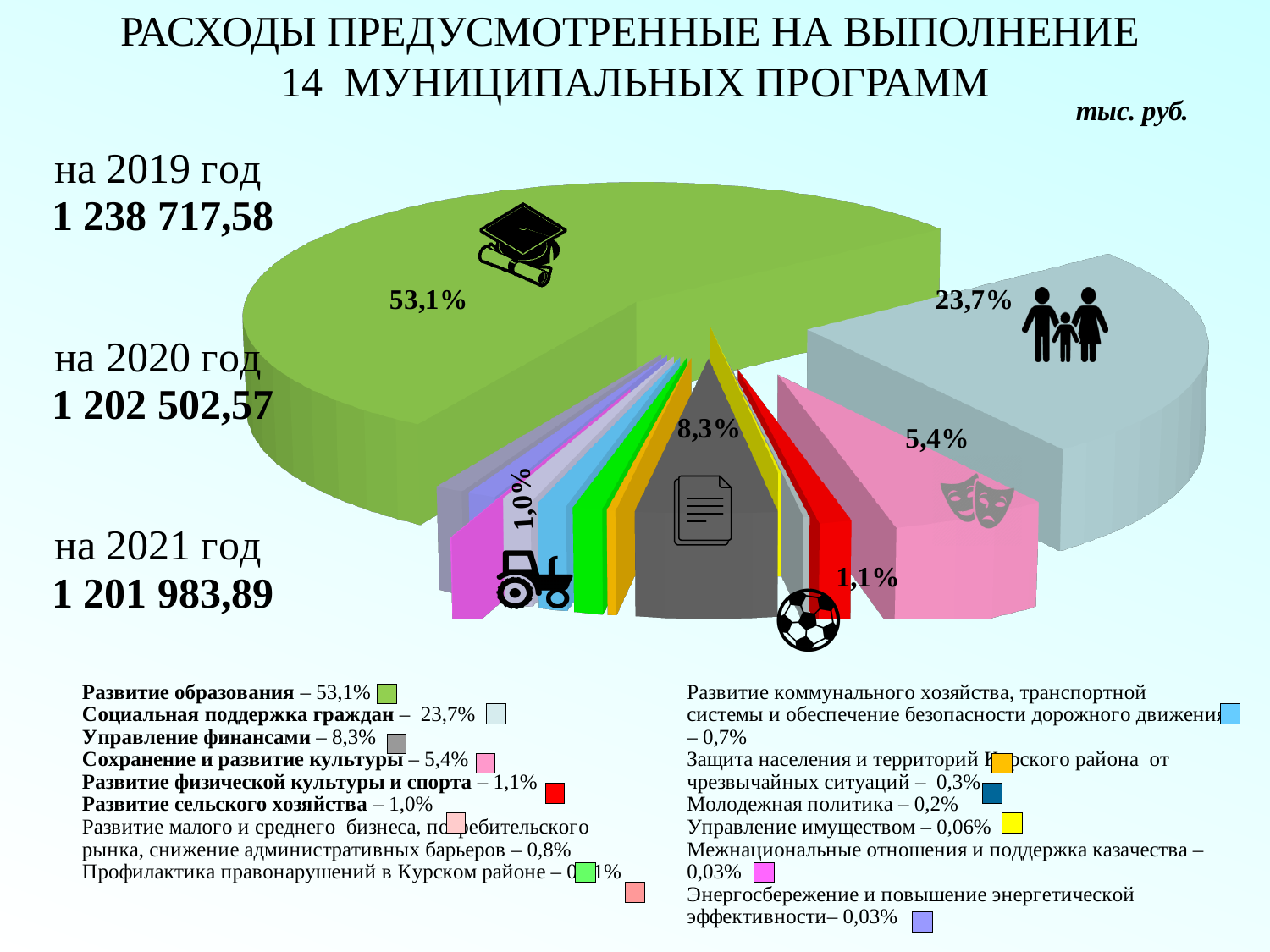
What is the difference in percentage points between Развитие образования and Социальная поддержка граждан? 29,4 What is the difference in percentage points between Социальная поддержка граждан and Управление финансами? 15,4 What percentage is shown for Социальная поддержка граждан? 23,7% What percentage is shown for Развитие физической культуры и спорта? 1,1% Which program has the largest share of the pie? Развитие образования What kind of chart is shown on the slide? Pie chart What unit is indicated for the expenditure figures on the slide? тыс. руб. What share of the pie does Развитие сельского хозяйства take? 1,0% Which is larger: the share for Управление финансами or for Сохранение и развитие культуры? Управление финансами What percentage is shown for Развитие образования? 53,1% What percentage is shown for Сохранение и развитие культуры? 5,4% What percentage is shown for Управление финансами? 8,3%